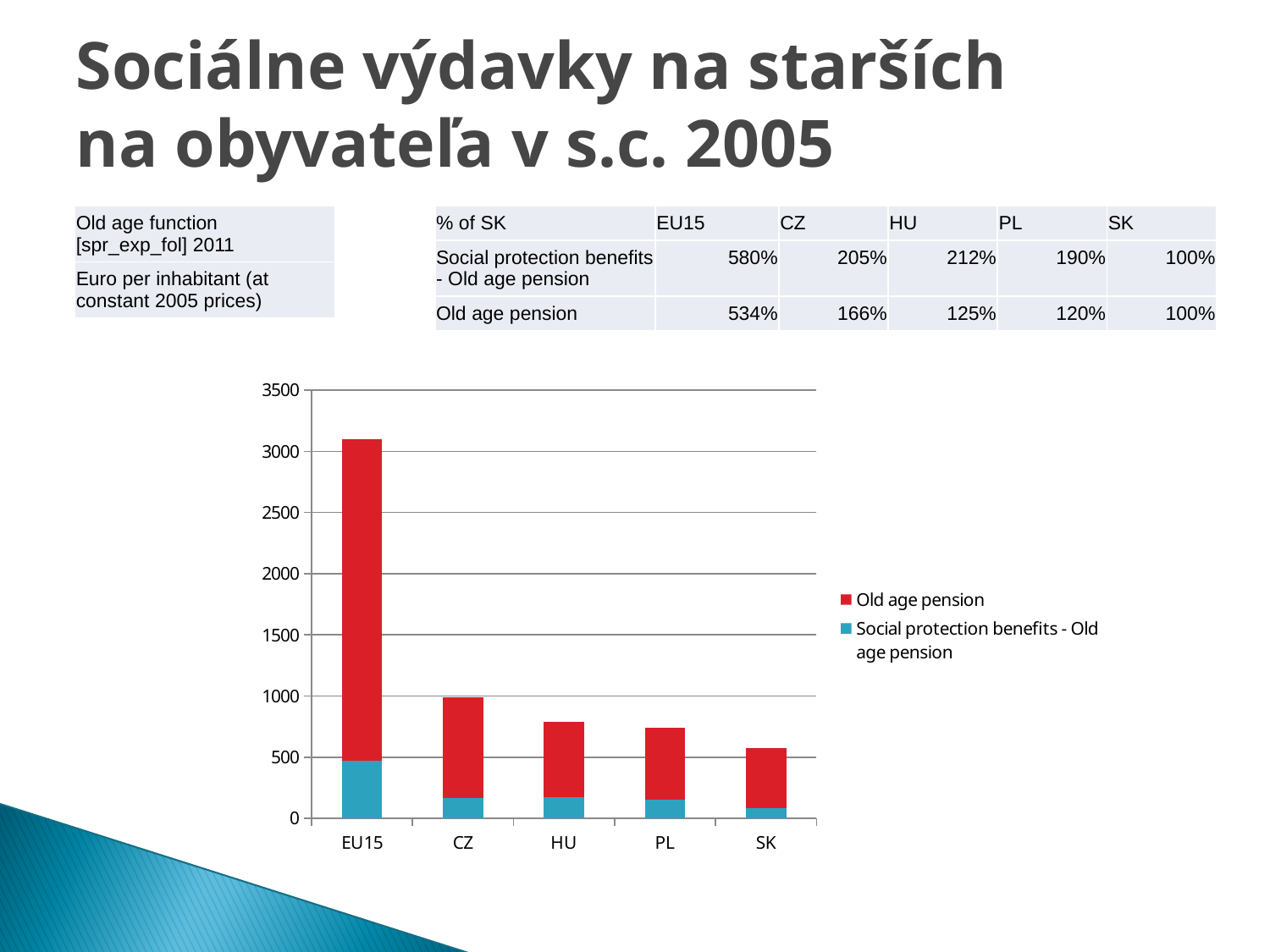
Do the total bar heights rise or fall moving from EU15 to SK along the x axis? fall Which colour represents the 'Old age pension' series in the chart? red What kind of chart is shown on the slide? stacked bar chart Is the total stacked bar for EU15 greater or less than 2500? greater How many series does the chart legend list? 2 How many countries/categories are shown on the x axis of the chart? 5 Which has the larger total stacked bar, CZ or HU? CZ Which category has the tallest stacked bar in the chart? EU15 Is the total stacked bar for SK greater or less than 500? greater Is the total stacked bar for HU greater or less than 1000? less Which category has the shortest stacked bar in the chart? SK